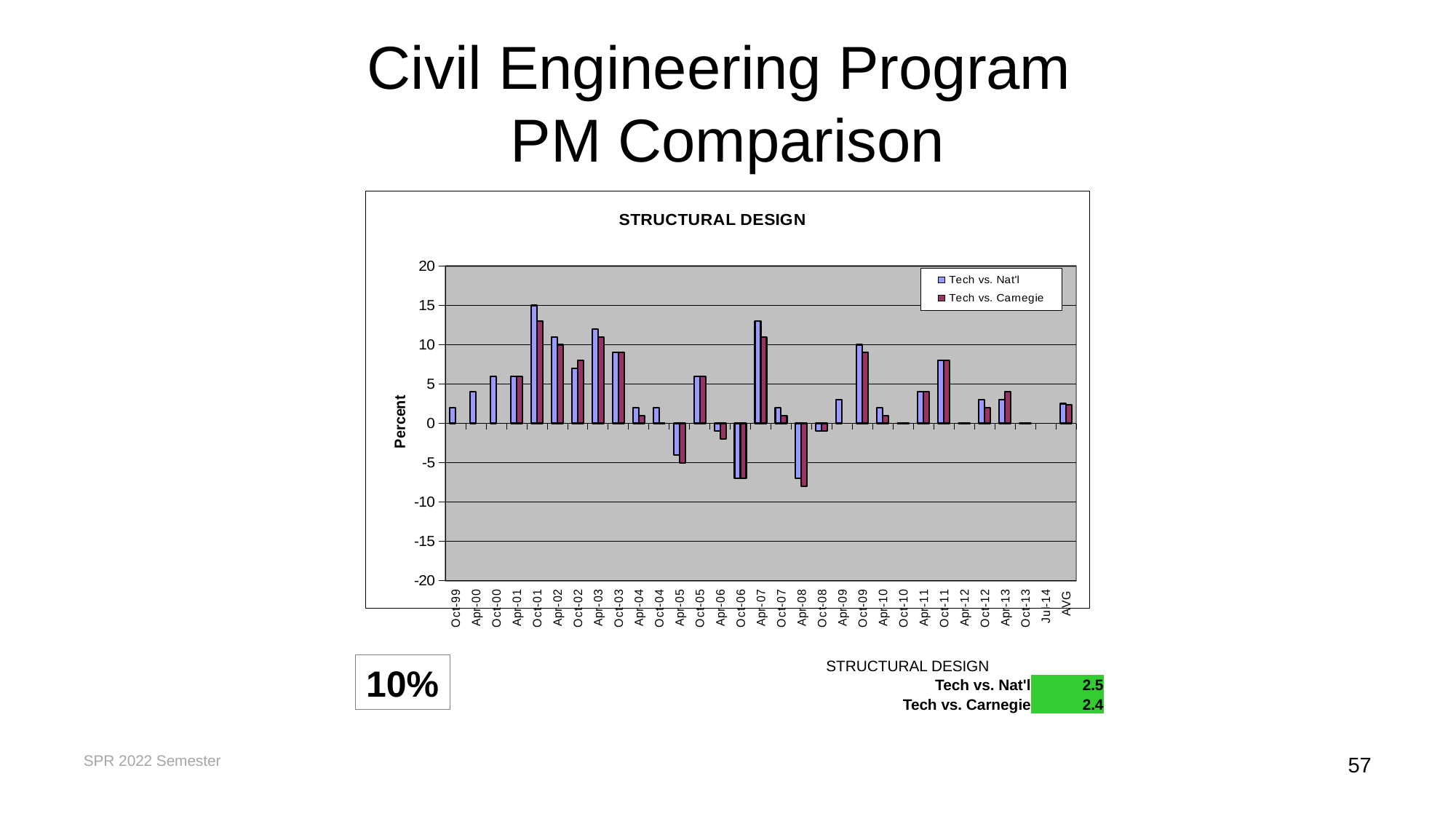
What is the title of the chart? STRUCTURAL DESIGN Is the Tech vs. Nat'l value for Oct-06 greater or less than -5? less How many series does the chart legend list? 2 Which is larger, the Tech vs. Nat'l value for Oct-01 or for Apr-07? Oct-01 What is the difference between the AVG values for Tech vs. Nat'l and Tech vs. Carnegie? 0.1 What type of chart is shown on the slide? bar chart What is the AVG value for Tech vs. Carnegie, as shown in the table below the chart? 2.4 How many categories are shown along the x axis, including AVG? 31 What is the AVG value for Tech vs. Nat'l, as shown in the table below the chart? 2.5 Which period has the highest Tech vs. Nat'l value? Oct-01 What are the two series named in the legend? Tech vs. Nat'l and Tech vs. Carnegie Is the Tech vs. Nat'l value for Apr-07 greater or less than 10? greater